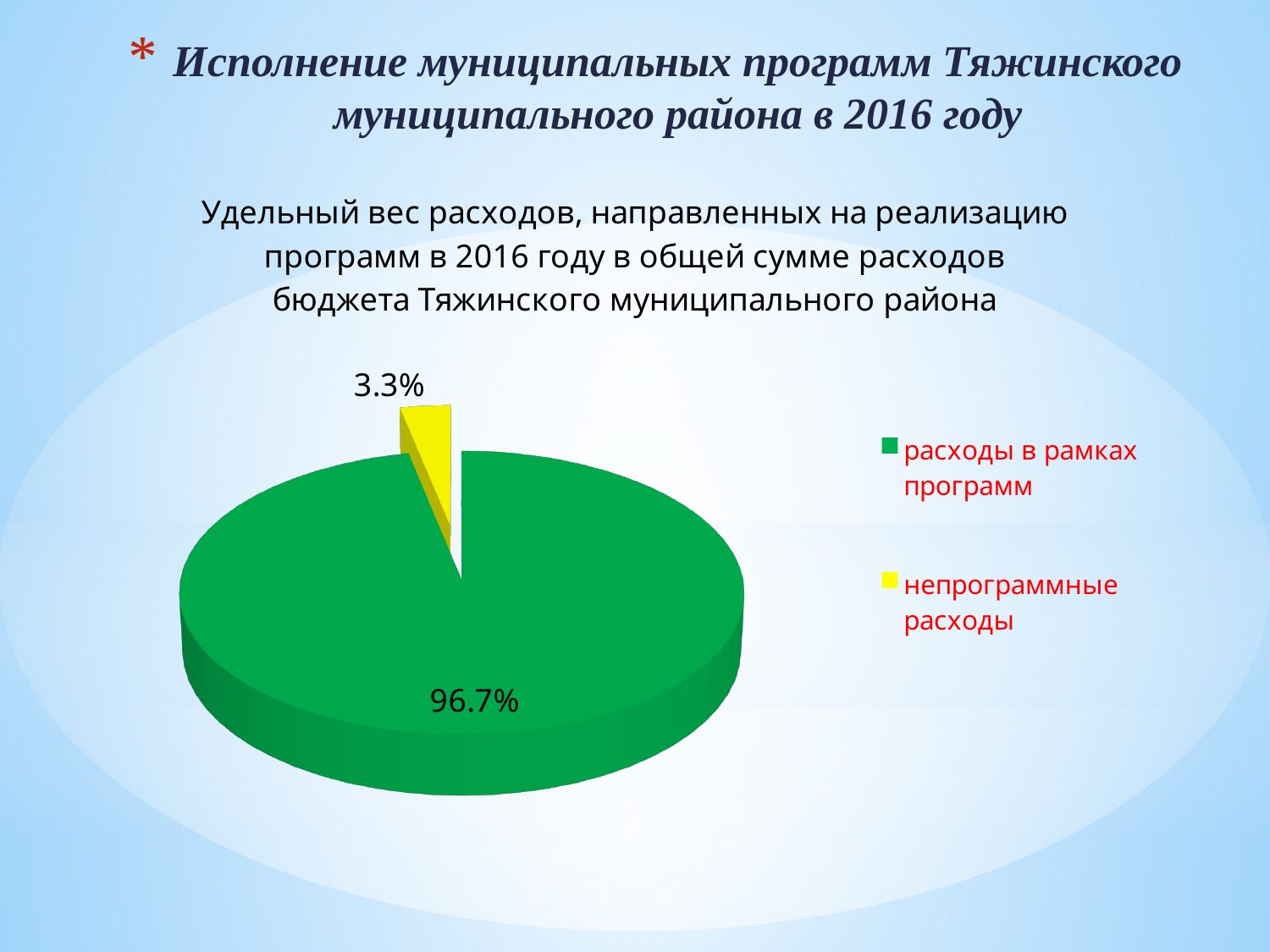
Which is larger: the share for "расходы в рамках программ" or for "непрограммные расходы"? расходы в рамках программ What is the difference in percentage points between "расходы в рамках программ" and "непрограммные расходы"? 93.4 What kind of chart is shown on the slide? pie chart What colour is the slice for "расходы в рамках программ"? green How many slices does the pie chart have? 2 How many entries does the legend list? 2 What colour is the slice for "непрограммные расходы"? yellow What share of the pie is labelled "расходы в рамках программ"? 96.7% Which slice of the pie is the largest? расходы в рамках программ Which slice of the pie is the smallest? непрограммные расходы What share of the pie is labelled "непрограммные расходы"? 3.3%